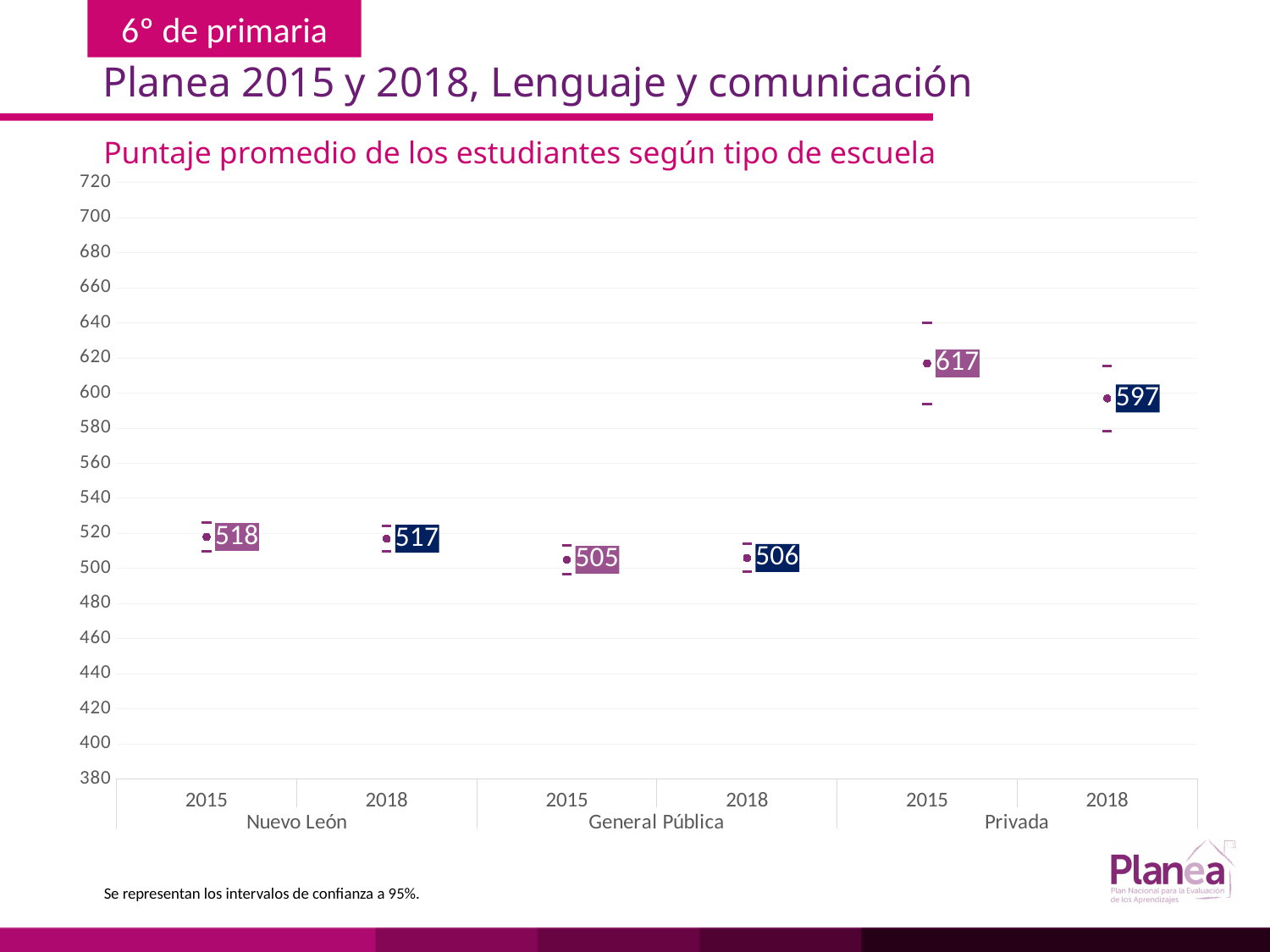
What is the average score for Privada schools in 2018? 597 What is the difference between the Nuevo León score and the General Pública score in 2018? 11 Which is larger, the Nuevo León score in 2015 or the General Pública score in 2015? Nuevo León 2015 Which school type and year has the highest average score? Privada, 2015 Which school type and year has the lowest average score? General Pública, 2015 What is the average score for General Pública schools in 2015? 505 What is the subtitle of the chart? Puntaje promedio de los estudiantes según tipo de escuela How many data points are plotted on the chart? 6 Is the Privada score in 2015 greater or less than 600? greater What is the average score for Nuevo León in 2015? 518 Did the Privada average score rise or fall from 2015 to 2018? fall What is the difference between the Privada scores in 2015 and 2018? 20